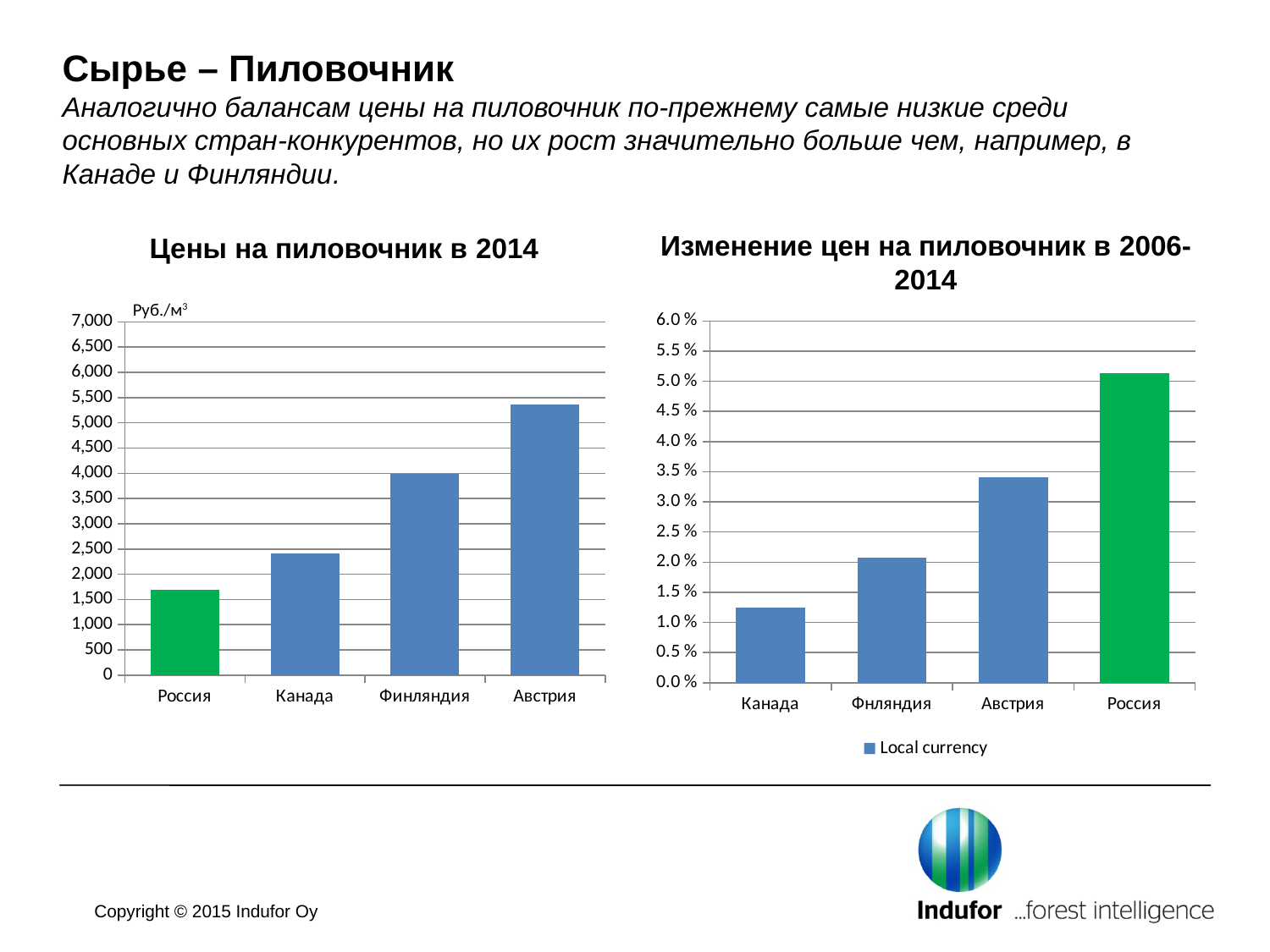
In the chart 'Цены на пиловочник в 2014', is the value for Финляндия greater or less than 3,500? greater In the chart 'Цены на пиловочник в 2014', which country has the highest price? Австрия In the chart 'Изменение цен на пиловочник в 2006-2014', which country has the lowest value? Канада What kind of chart is 'Изменение цен на пиловочник в 2006-2014'? bar chart In the chart 'Цены на пиловочник в 2014', is the value for Россия greater or less than 2,000? less In the chart 'Цены на пиловочник в 2014', which country has the lowest price? Россия In the chart 'Изменение цен на пиловочник в 2006-2014', which country has the highest value? Россия In the chart 'Изменение цен на пиловочник в 2006-2014', is the value for Австрия greater or less than 3.0 %? greater In the chart 'Цены на пиловочник в 2014', which is larger, the value for Канада or the value for Финляндия? Финляндия What is the legend entry shown under the chart 'Изменение цен на пиловочник в 2006-2014'? Local currency How many countries are shown in the chart 'Цены на пиловочник в 2014'? 4 In the chart 'Изменение цен на пиловочник в 2006-2014', do the values rise or fall from left to right along the x axis? rise